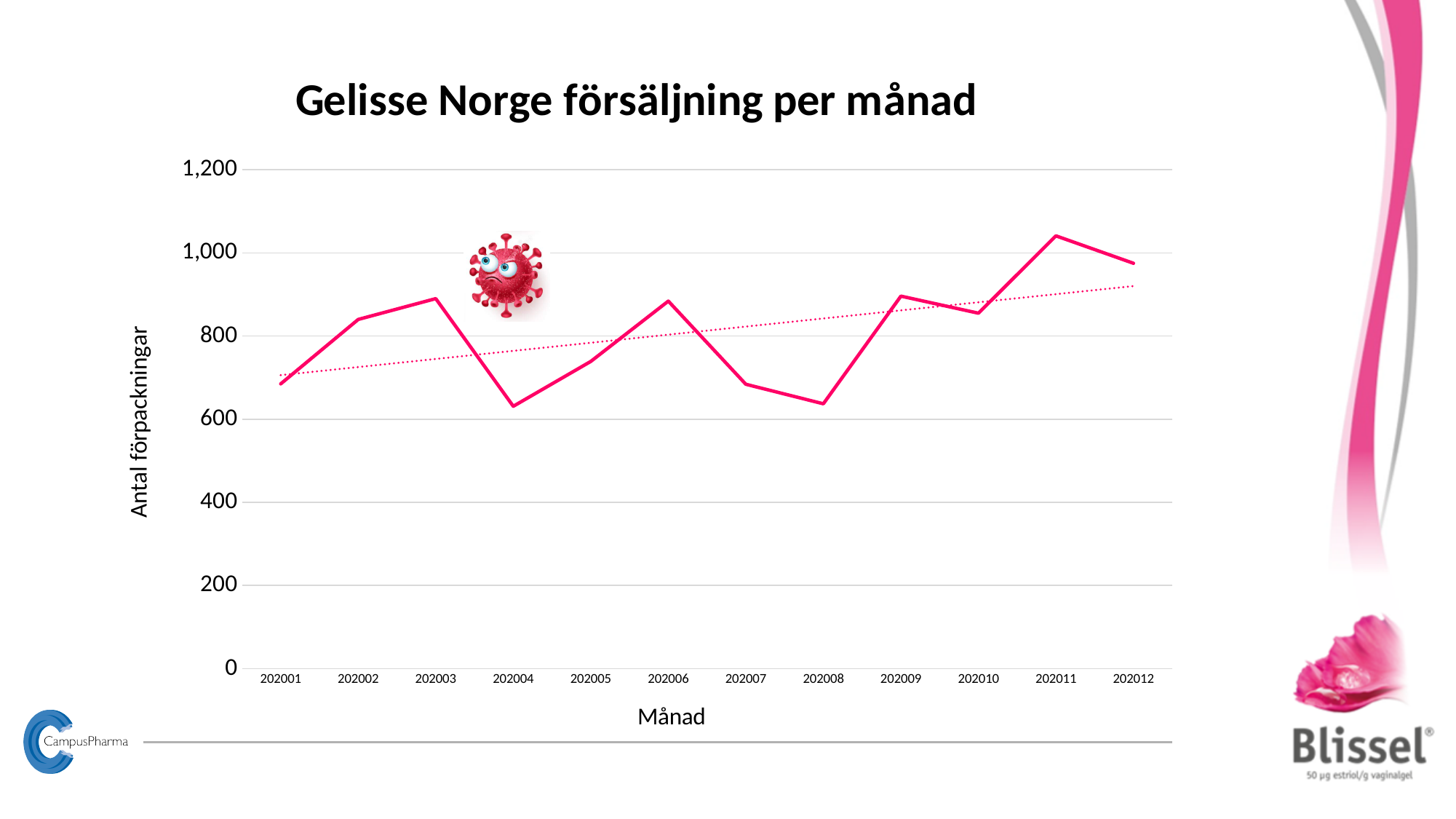
Does the dotted trend line rise or fall from 202001 to 202012? rise Which is larger, the value for 202009 or the value for 202008? 202009 What is the label of the vertical axis? Antal förpackningar Which month has the highest value? 202011 What kind of chart is shown on the slide? line chart Is the value for 202002 greater or less than 800? greater Is the value for 202004 greater or less than 800? less How many months are plotted on the x axis? 12 Is the value for 202008 greater or less than 800? less Which is larger, the value for 202003 or the value for 202004? 202003 What is the title of the chart? Gelisse Norge försäljning per månad